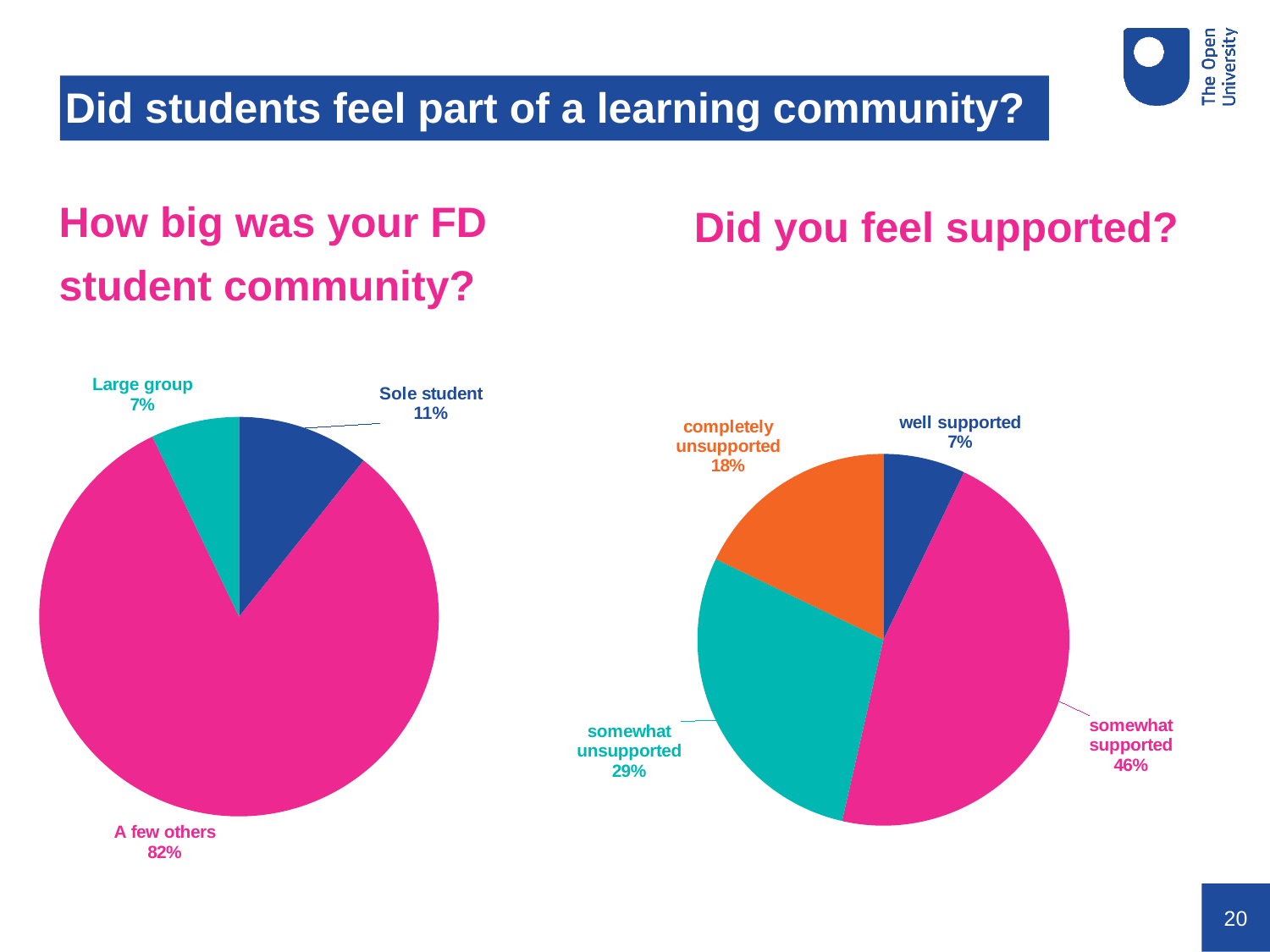
In the 'Did you feel supported?' chart, what share is 'completely unsupported'? 18% In the 'Did you feel supported?' chart, which category has the smallest share? well supported In the 'Did you feel supported?' chart, which is larger: 'somewhat unsupported' or 'completely unsupported'? somewhat unsupported In the 'Did you feel supported?' chart, which category has the largest share? somewhat supported In the 'How big was your FD student community?' chart, how many slices does the pie have? 3 In the 'Did you feel supported?' chart, what is the difference between 'somewhat supported' and 'somewhat unsupported'? 17% In the 'Did you feel supported?' chart, what share is 'somewhat unsupported'? 29% In the 'How big was your FD student community?' chart, what share is 'A few others'? 82% In the 'How big was your FD student community?' chart, which category has the smallest share? Large group In the 'How big was your FD student community?' chart, what is the difference between 'Sole student' and 'Large group'? 4% In the 'How big was your FD student community?' chart, what share is 'Sole student'? 11% What type of chart is used on the right side of the slide for 'Did you feel supported?'? Pie chart